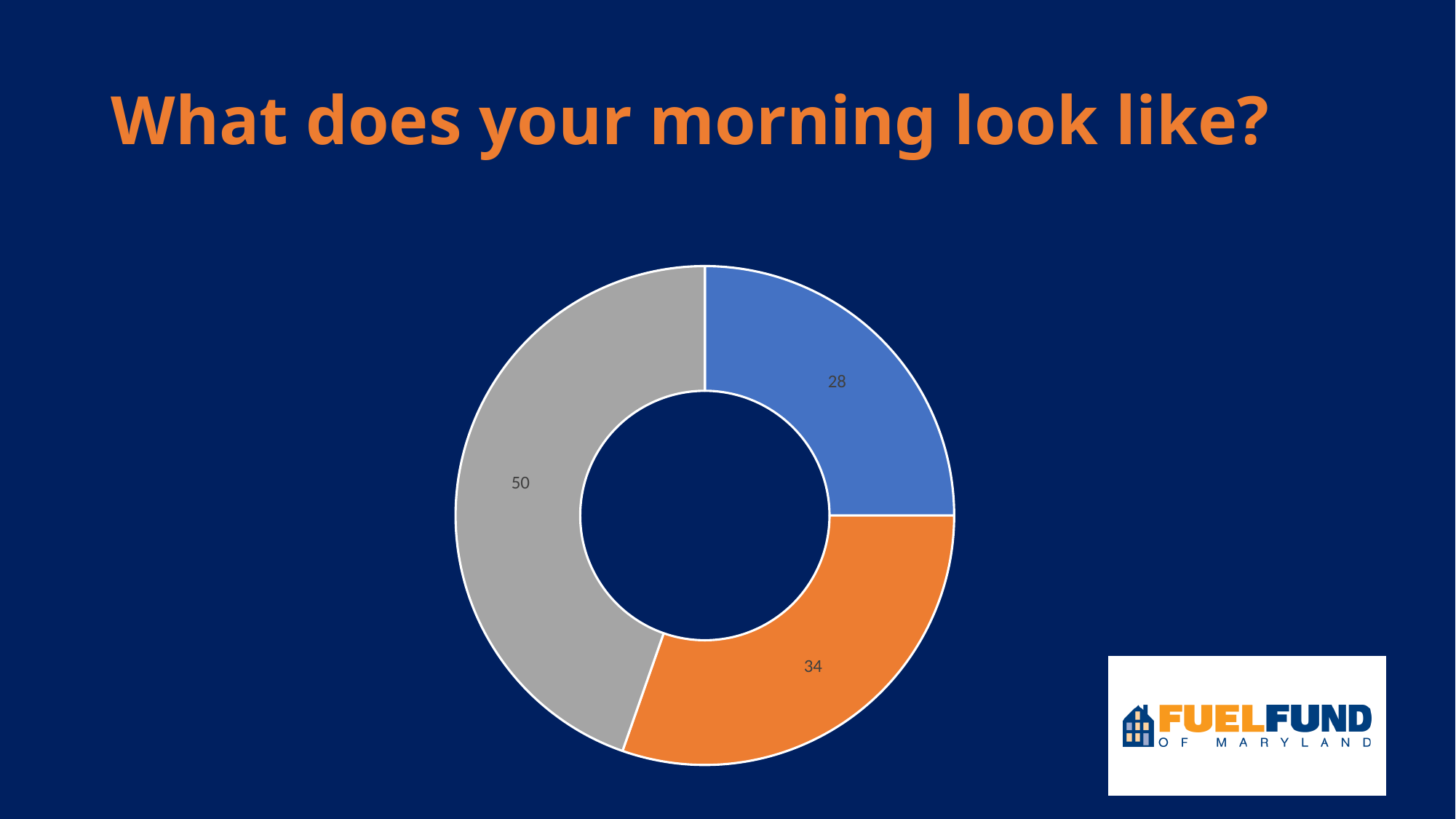
How many slices does the doughnut chart have? 3 Which is larger, the orange slice or the blue slice? The orange slice Which slice of the doughnut chart has the largest value? The gray slice (50) What is the difference between the gray slice and the blue slice values? 22 What share of the total does the blue slice (28) represent? 25% What value is shown on the gray slice of the doughnut chart? 50 What value is shown on the blue slice of the doughnut chart? 28 What is the total of all three slice values in the doughnut chart? 112 What kind of chart is shown on the slide? Doughnut chart Which slice of the doughnut chart has the smallest value? The blue slice (28) What value is shown on the orange slice of the doughnut chart? 34 What is the difference between the orange slice and the blue slice values? 6